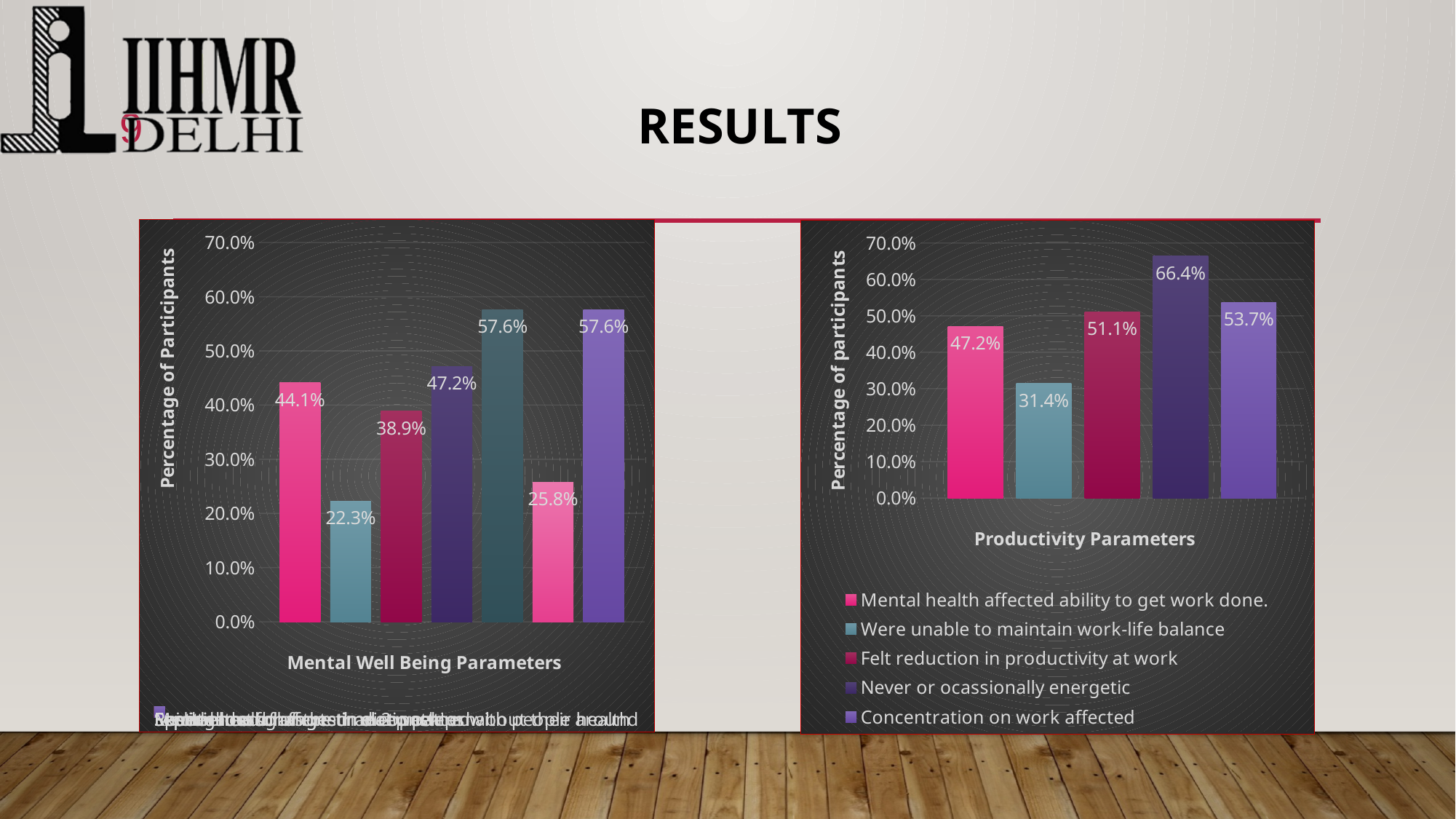
In the Productivity Parameters chart, which legend category has the highest value? Never or ocassionally energetic In the Productivity Parameters chart, which is larger: 'Concentration on work affected' or 'Felt reduction in productivity at work'? Concentration on work affected In the Productivity Parameters chart, what percentage of participants were unable to maintain work-life balance? 31.4% In the Productivity Parameters chart, what is the value for 'Never or ocassionally energetic'? 66.4% In the Productivity Parameters chart, which legend category has the lowest value? Were unable to maintain work-life balance What type of chart is the Productivity Parameters chart? Bar chart How many bars are plotted in the Mental Well Being Parameters chart? 7 In the Mental Well Being Parameters chart, what is the value of the lowest bar? 22.3% How many series does the legend of the Productivity Parameters chart list? 5 In the Mental Well Being Parameters chart, what is the value of the first (leftmost) bar? 44.1% In the Productivity Parameters chart, what is the value for 'Concentration on work affected'? 53.7% In the Productivity Parameters chart, what is the difference between 'Felt reduction in productivity at work' and 'Mental health affected ability to get work done.'? 3.9%